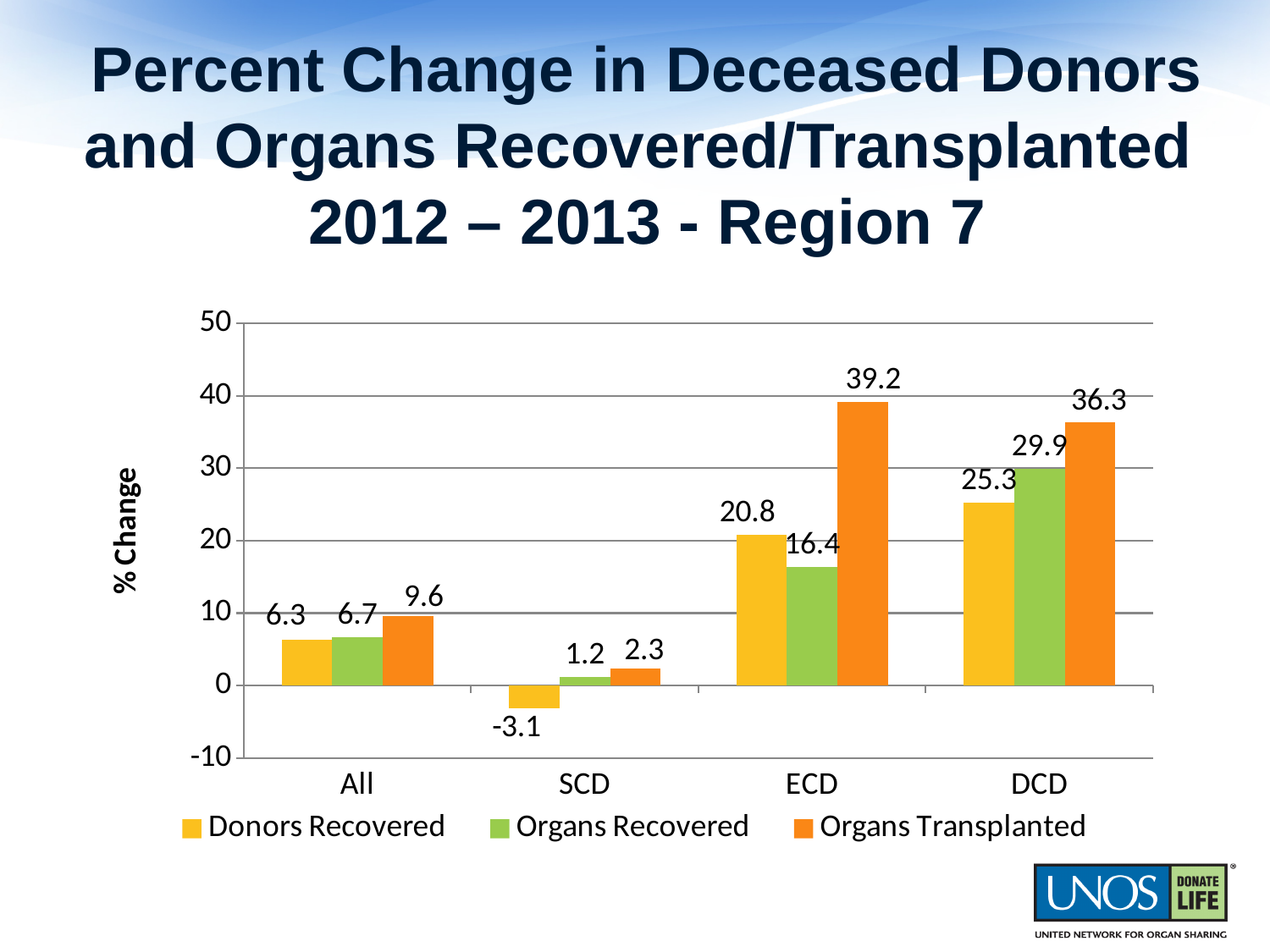
Which is larger in the ECD category: Donors Recovered or Organs Recovered? Donors Recovered What is the value for Organs Transplanted in the ECD category? 39.2 What kind of chart is shown on the slide? bar chart What is the value for Organs Recovered in the DCD category? 29.9 Which category has the highest value for Organs Transplanted? ECD What is the value for Donors Recovered in the SCD category? -3.1 How many series does the legend list? 3 What is the label of the vertical axis? % Change Is the value for Organs Transplanted in the All category greater or less than 10? less What is the difference between Organs Transplanted and Donors Recovered in the DCD category? 11 Which category has the lowest value for Donors Recovered? SCD How many categories are shown on the x axis? 4